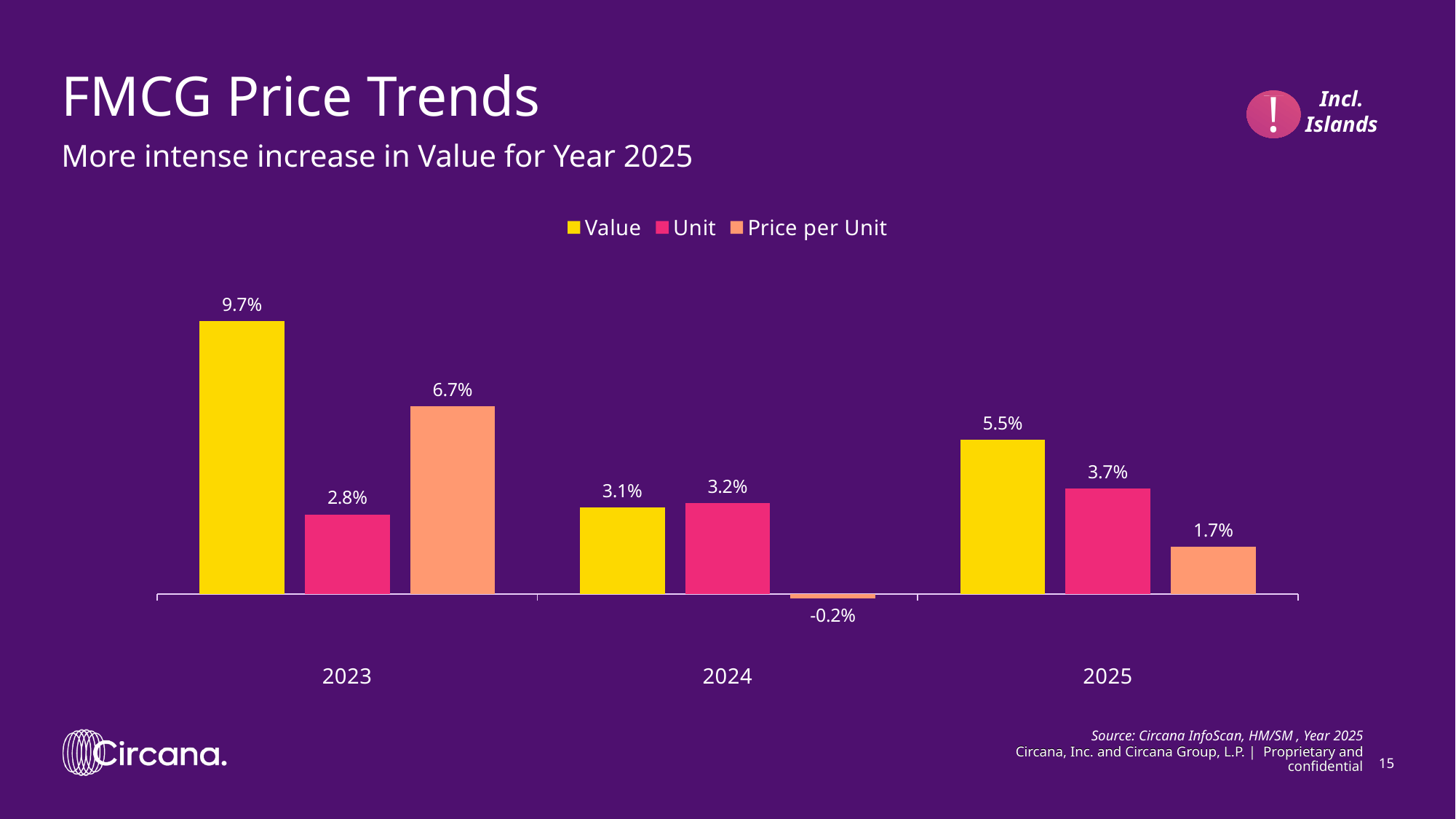
How many years are shown on the x axis? 3 Which series is shown in yellow? Value How many series does the legend list? 3 What is the difference between the Value growth in 2023 and in 2025? 4.2% What is the Unit growth for 2025? 3.7% Does the Unit growth rise or fall from 2023 to 2025? Rise Which year has the highest Value growth? 2023 What is the Price per Unit change for 2024? -0.2% What is the Value growth for 2023? 9.7% Which year has the lowest Price per Unit change? 2024 Which is larger in 2024, Value growth or Unit growth? Unit What kind of chart is shown on the slide? Bar chart